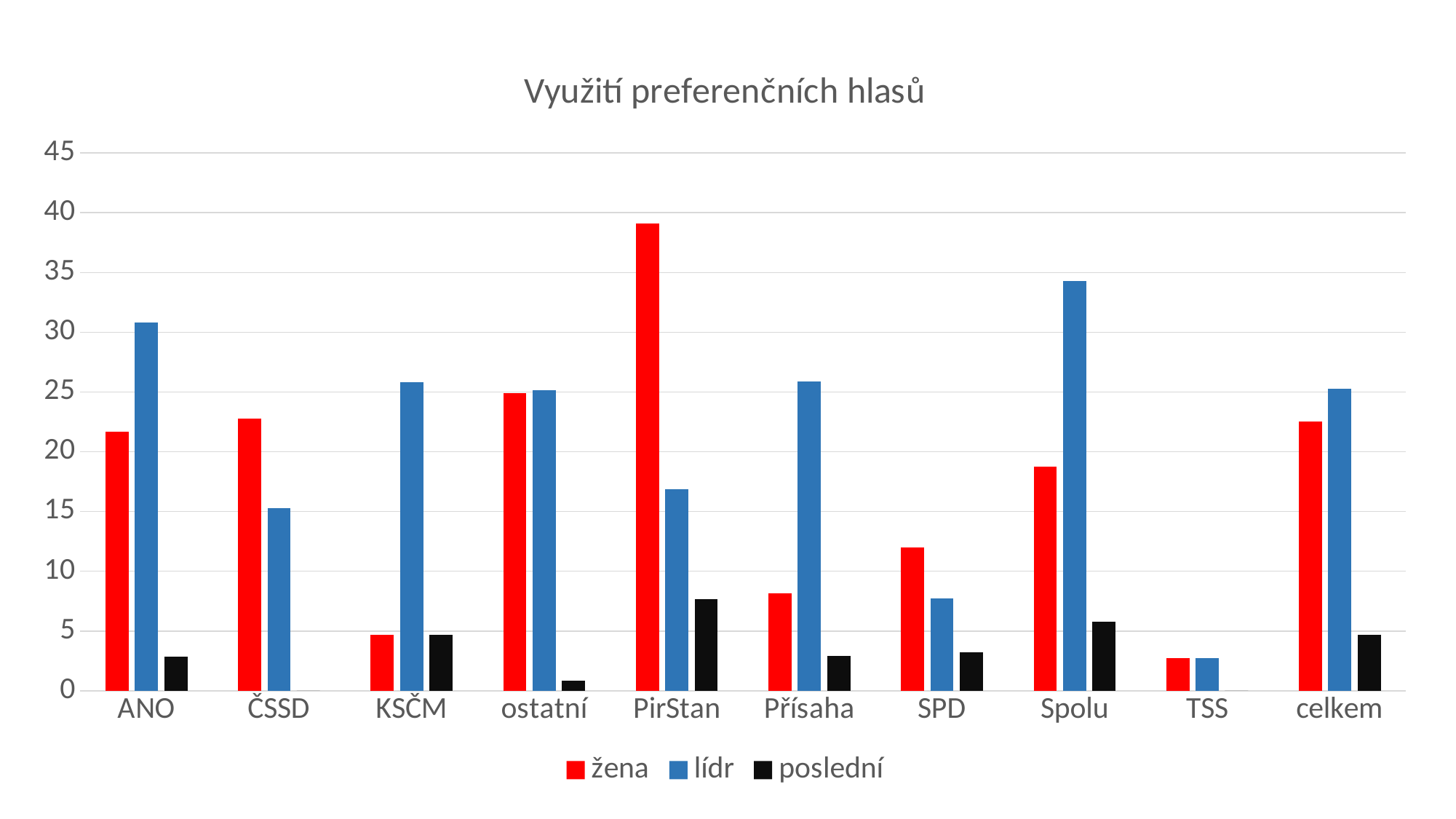
What kind of chart is shown on the slide? bar chart For ČSSD, which is larger: the žena value or the lídr value? žena Is the lídr value for ANO greater or less than 30? greater Is the žena value for PirStan greater or less than 35? greater Which category has the highest value for the žena series? PirStan Is the žena value for SPD greater or less than 10? greater For Spolu, which is larger: the žena value or the lídr value? lídr What is the title of the chart? Využití preferenčních hlasů How many series does the legend list? 3 Which category has the lowest value for the lídr series? TSS Which category has the highest value for the lídr series? Spolu How many categories are shown on the x axis? 10